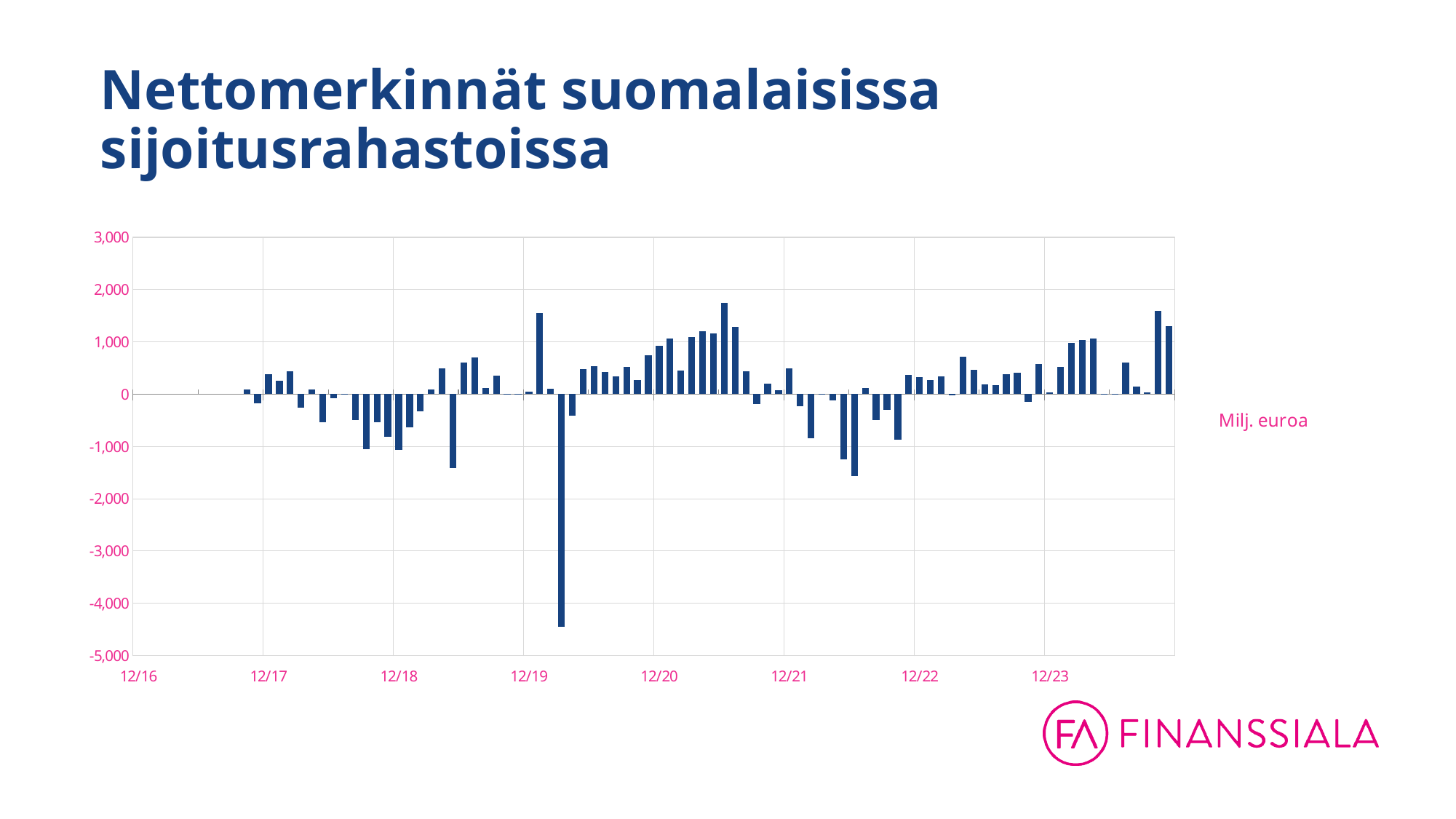
Between which two x-axis labels does the lowest bar on the chart appear? 12/19 and 12/20 What unit label is shown next to the chart? Milj. euroa Is the lowest bar between 12/21 and 12/22 greater or less than -1,000? less What kind of chart is shown on the slide? bar chart Is the lowest value on the chart greater or less than -4,000? less What is the lowest value shown on the y axis? -5,000 How many date labels are shown on the x axis? 8 Is the highest value on the chart greater or less than 1,000? greater What is the title of the chart? Nettomerkinnät suomalaisissa sijoitusrahastoissa